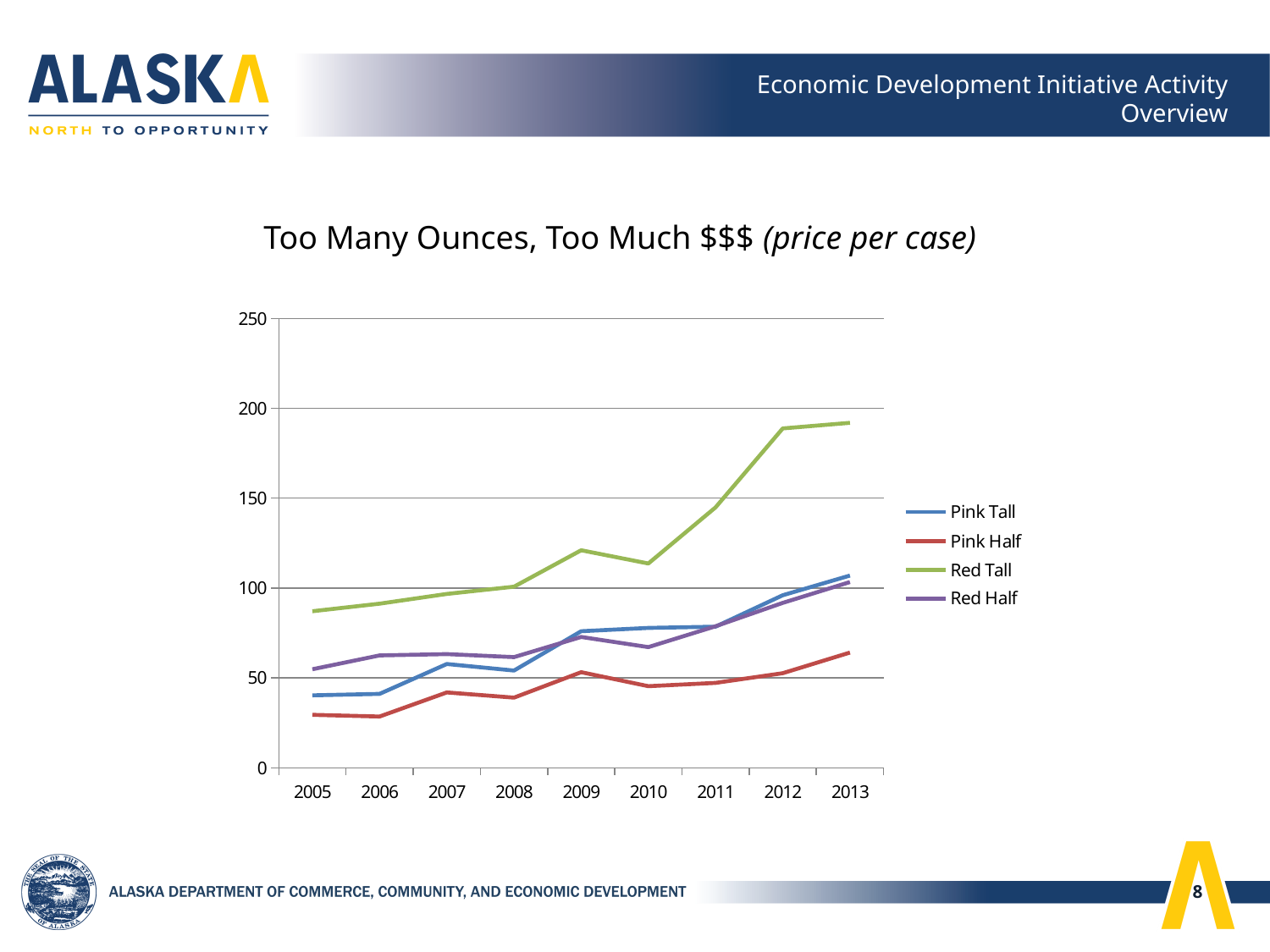
How many series does the legend list? 4 In which year does the Pink Tall series reach its highest value? 2013 Which series has the lowest value in 2013? Pink Half What kind of chart is shown on the slide? line chart Does the Red Tall series rise or fall overall from 2005 to 2013? rise Is the value for Pink Half in 2005 greater or less than 50? less Is the value for Red Tall in 2012 greater or less than 150? greater Is the value for Red Tall in 2005 greater or less than 100? less What is the title of the chart? Too Many Ounces, Too Much $$$ (price per case) In 2010, which is larger: Red Tall or Pink Tall? Red Tall Which series has the highest value in 2013? Red Tall How many years are shown on the x axis? 9